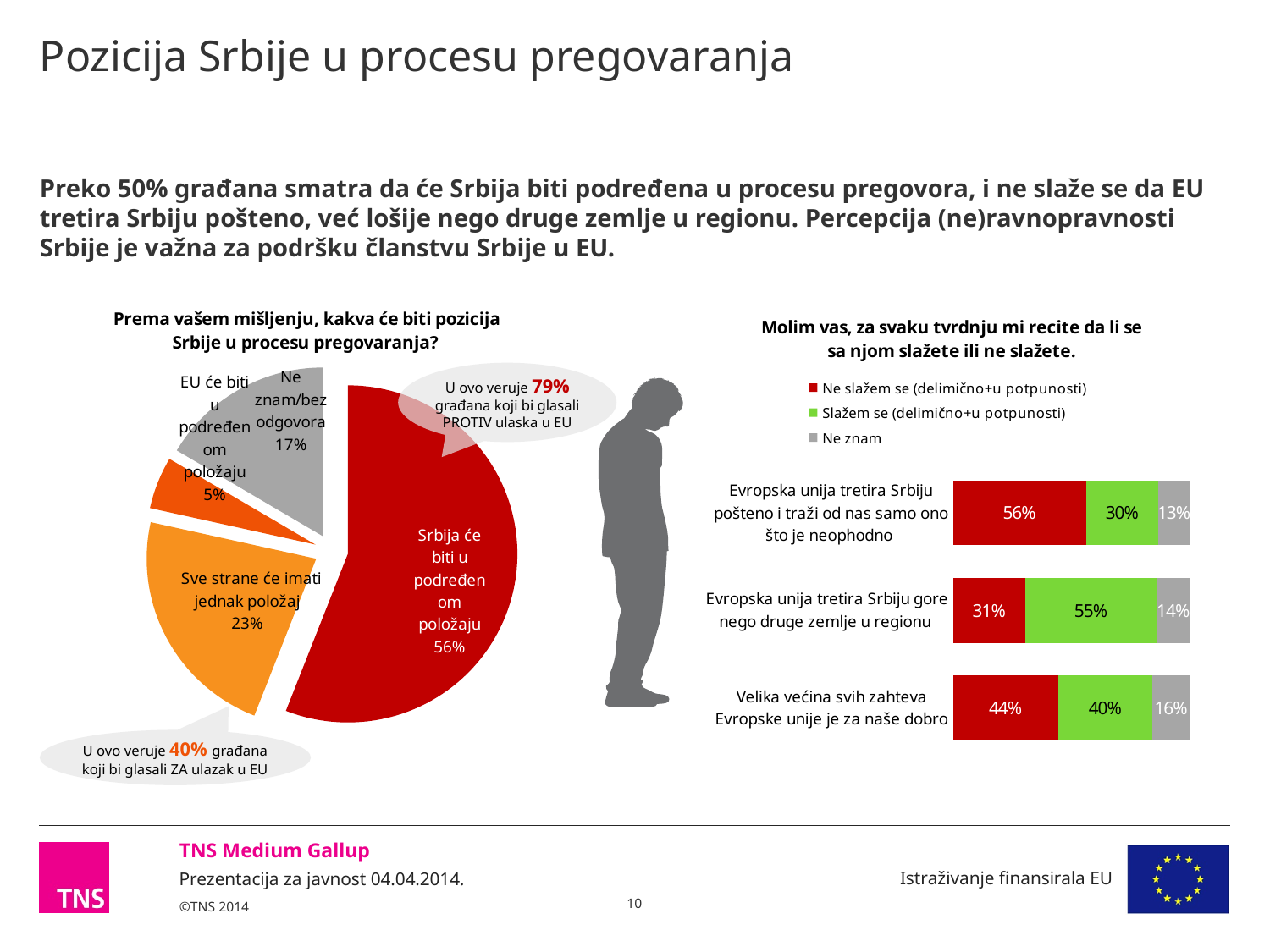
In the bar chart on the right, which is larger for 'Velika većina svih zahteva Evropske unije je za naše dobro': 'Ne slažem se' or 'Slažem se'? Ne slažem se In the pie chart on the left, which answer has the smallest slice? EU će biti u podređenom položaju In the bar chart on the right, what is the 'Ne znam' value for 'Velika većina svih zahteva Evropske unije je za naše dobro'? 16% In the bar chart on the right, what percentage agree (Slažem se) that the EU treats Serbia worse than other countries in the region? 55% What type of chart is shown on the left side of the slide? Pie chart In the bar chart on the right, how many series does the legend list? 3 In the pie chart on the left, what share of respondents said Serbia will be in a subordinate position (Srbija će biti u podređenom položaju)? 56% In the pie chart on the left, how many slices are there? 4 In the pie chart on the left, what is the difference in percentage points between 'Srbija će biti u podređenom položaju' and 'Sve strane će imati jednak položaj'? 33 percentage points In the bar chart on the right, which statement has the highest 'Slažem se' value? Evropska unija tretira Srbiju gore nego druge zemlje u regionu In the bar chart on the right, what percentage disagree (Ne slažem se) with the statement 'Evropska unija tretira Srbiju pošteno i traži od nas samo ono što je neophodno'? 56% In the pie chart on the left, what percentage answered 'Sve strane će imati jednak položaj'? 23%